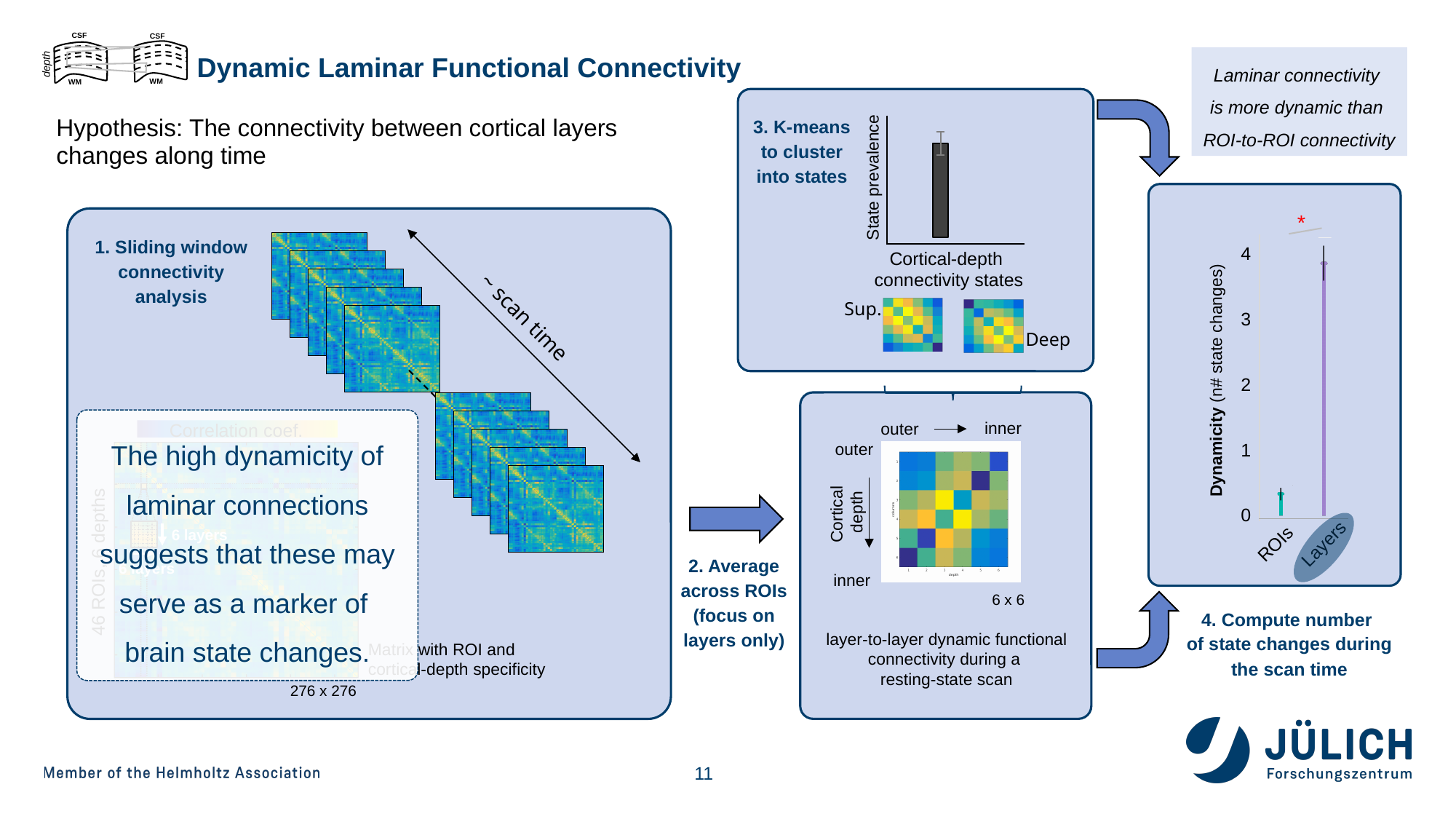
In the 'Dynamicity (n# state changes)' bar chart, which category has the highest value? Layers How many bars are plotted in the 'State prevalence' chart in the '3. K-means to cluster into states' box? 1 In the 'Dynamicity (n# state changes)' bar chart, is the value for ROIs greater or less than 1? less What kind of chart is the 'State prevalence' chart in the '3. K-means to cluster into states' box? bar chart In the 'Dynamicity (n# state changes)' bar chart, is the value for Layers greater or less than 3? greater What is the label of the y axis on the bar chart at the right of the slide? Dynamicity (n# state changes) What is the highest tick value shown on the y axis of the 'Dynamicity (n# state changes)' bar chart? 4 What kind of chart is the 'Dynamicity (n# state changes)' chart on the right of the slide? bar chart In the 'Dynamicity (n# state changes)' bar chart, which is larger: the value for ROIs or the value for Layers? Layers In the 'Dynamicity (n# state changes)' bar chart, which category has the lowest value? ROIs How many categories are shown on the x axis of the 'Dynamicity (n# state changes)' bar chart? 2